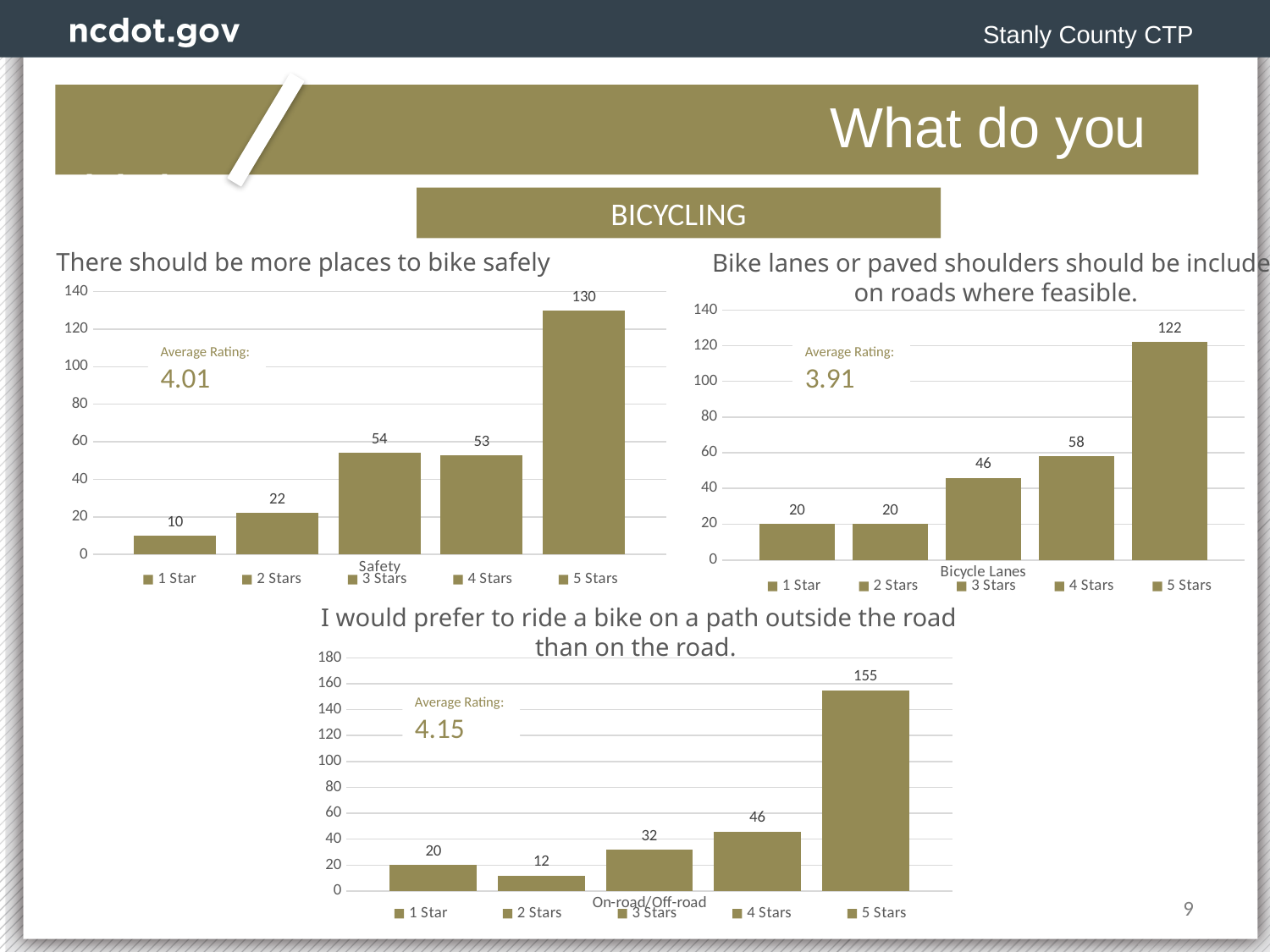
In the chart 'Bike lanes or paved shoulders should be included on roads where feasible', which rating has the highest value? 5 Stars What kind of chart is 'Bike lanes or paved shoulders should be included on roads where feasible'? bar chart In the chart 'I would prefer to ride a bike on a path outside the road than on the road', is the value for 5 Stars greater or less than 140? greater In the chart 'Bike lanes or paved shoulders should be included on roads where feasible', what is the difference between the 5 Stars and 4 Stars values? 64 In the chart 'I would prefer to ride a bike on a path outside the road than on the road', what is the value for 2 Stars? 12 In the chart 'There should be more places to bike safely', what is the difference between the 3 Stars and 2 Stars values? 32 In the chart 'I would prefer to ride a bike on a path outside the road than on the road', which is larger, the value for 1 Star or 3 Stars? 3 Stars In the chart 'There should be more places to bike safely', what is the value for 5 Stars? 130 How many series does the legend list in the chart 'There should be more places to bike safely'? 5 In the chart 'Bike lanes or paved shoulders should be included on roads where feasible', what is the value for 4 Stars? 58 In the chart 'There should be more places to bike safely', which rating has the lowest value? 1 Star What average rating is shown on the chart 'I would prefer to ride a bike on a path outside the road than on the road'? 4.15